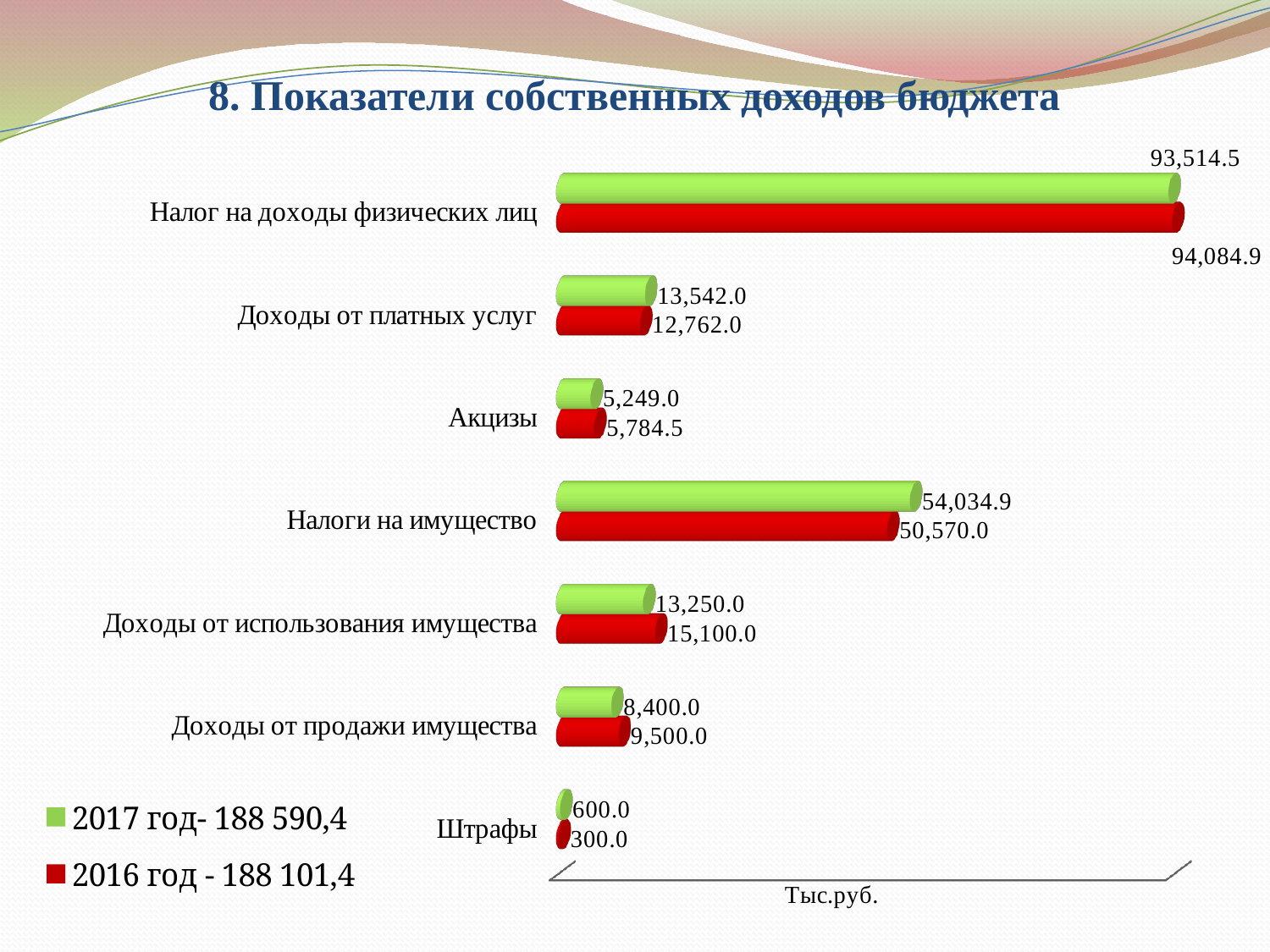
How many series does the legend list? 2 Which category has the highest value in the 2016 год series? Налог на доходы физических лиц What is the difference between the 2017 год and 2016 год values for Налоги на имущество? 3,464.9 What is the value for Налоги на имущество in the 2016 год series? 50,570.0 How many categories are shown on the chart? 7 What is the value for Налог на доходы физических лиц in the 2017 год series? 93,514.5 For Акцизы, which series has the larger value, 2017 год or 2016 год? 2016 год Which category has the lowest value in the 2017 год series? Штрафы What unit is indicated below the chart's axis? Тыс.руб. What is the difference between the 2016 год and 2017 год values for Доходы от использования имущества? 1,850.0 What kind of chart is shown on the slide? bar chart What is the value for Штрафы in the 2017 год series? 600.0